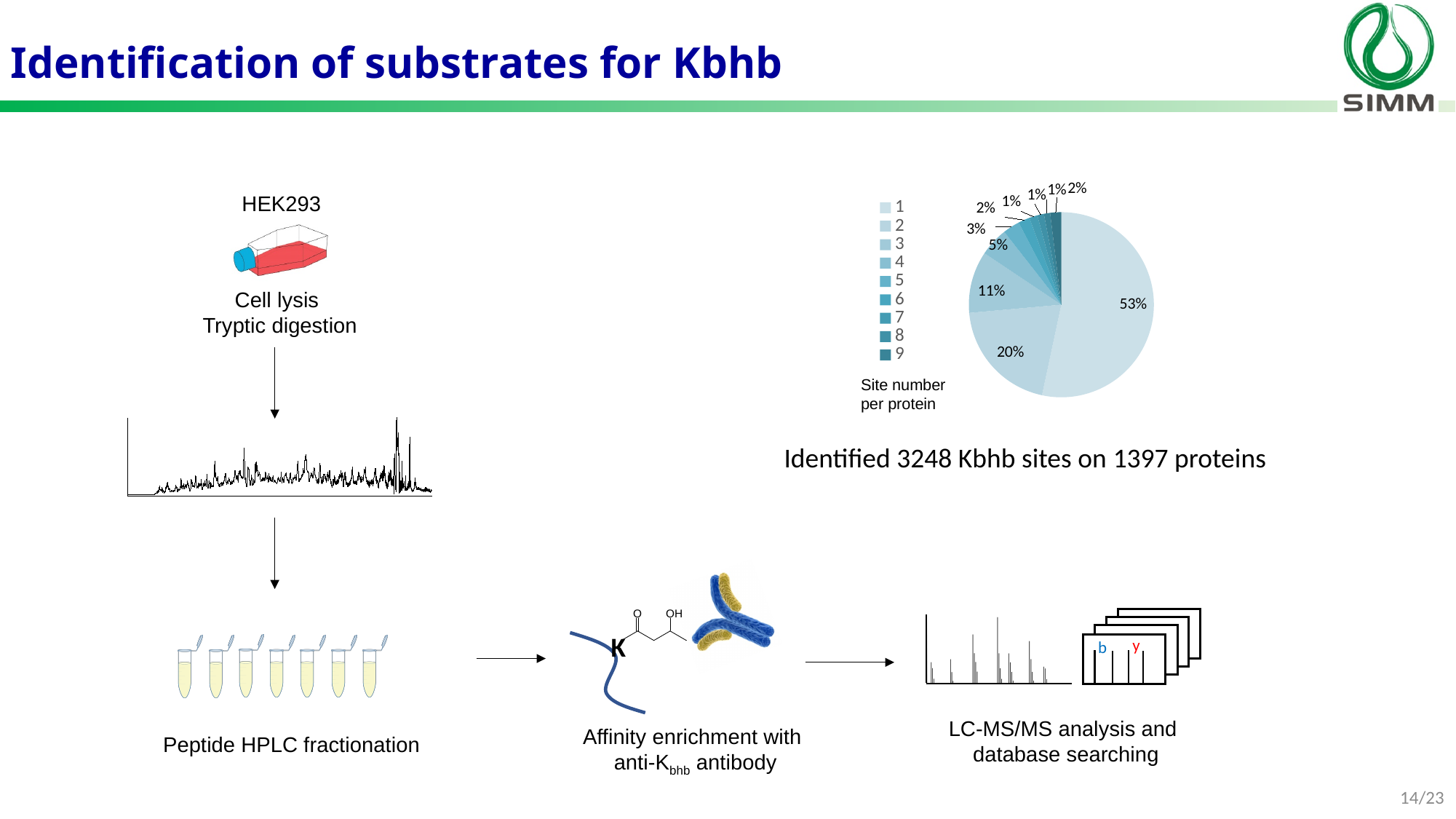
Which slice is larger in the pie chart: 2 sites per protein or 3 sites per protein? 2 sites per protein In the pie chart, what share is shown for proteins with 3 Kbhb sites? 11% In the pie chart, what share is labelled for site number 1 per protein (the largest slice)? 53% What kind of chart is shown on the slide? pie chart What does the legend of the pie chart represent, according to the caption beneath it? Site number per protein In the pie chart, what share is shown for proteins with 4 Kbhb sites? 5% What is the difference in percentage points between the slice for 1 site per protein and the slice for 2 sites per protein? 33 percentage points Is the share for 1 site per protein greater or less than 50%? greater How many entries does the pie chart's legend list? 9 In the pie chart, what share is shown for proteins with 2 Kbhb sites? 20% In the pie chart, what share is shown for proteins with 5 Kbhb sites? 3% Which site-number category has the largest slice in the pie chart? 1